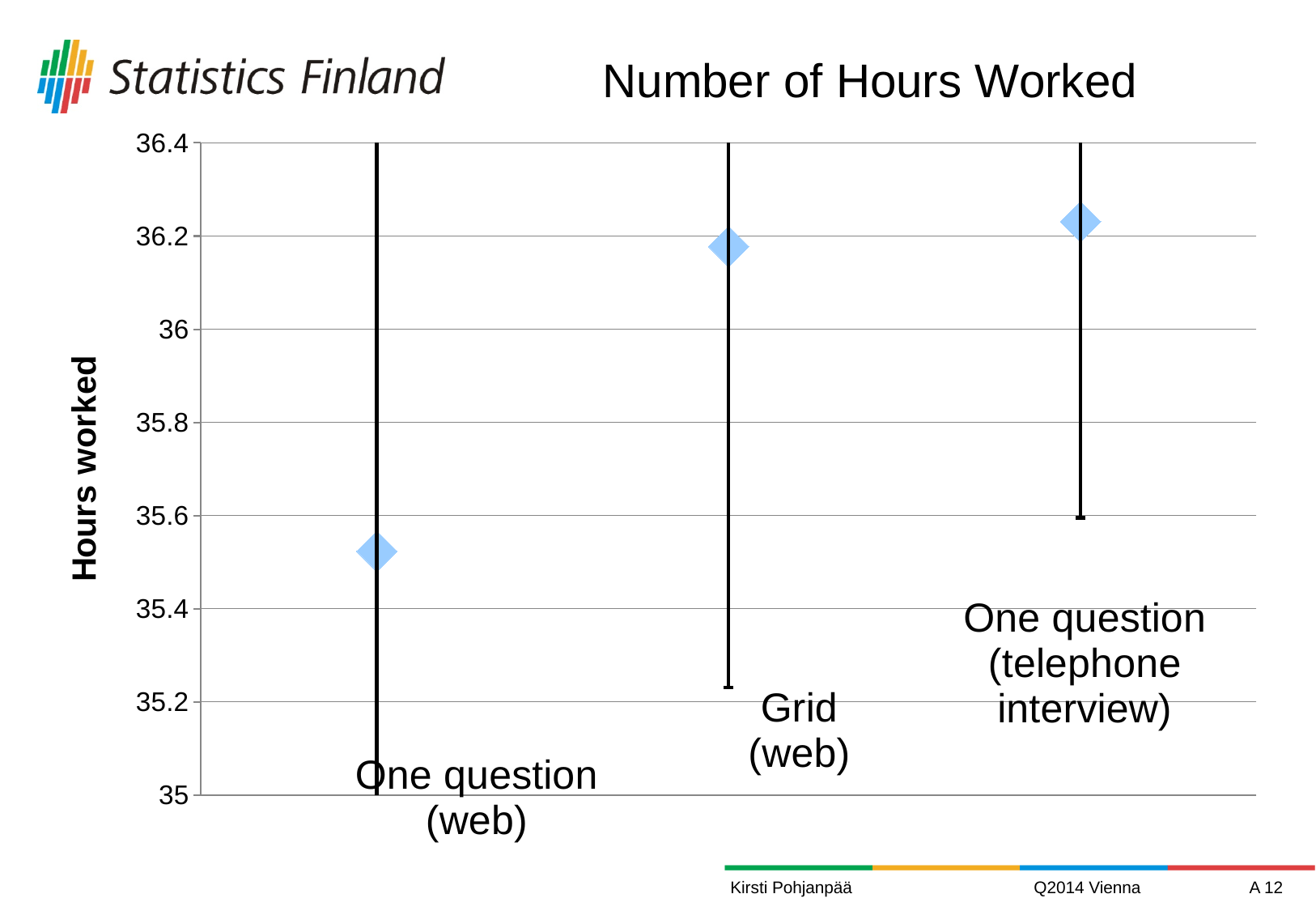
Is the value for Grid (web) greater or less than 36? greater Which has the higher plotted value, One question (web) or One question (telephone interview)? One question (telephone interview) Which category has the lowest plotted value for hours worked? One question (web) Which has the higher plotted value, One question (web) or Grid (web)? Grid (web) What is the title of the chart? Number of Hours Worked How many categories are plotted on the x axis? 3 Is the value for One question (telephone interview) greater or less than 36? greater What is the label of the vertical axis? Hours worked Is the value for One question (web) greater or less than 35.4? greater What is the lowest value shown on the vertical axis? 35